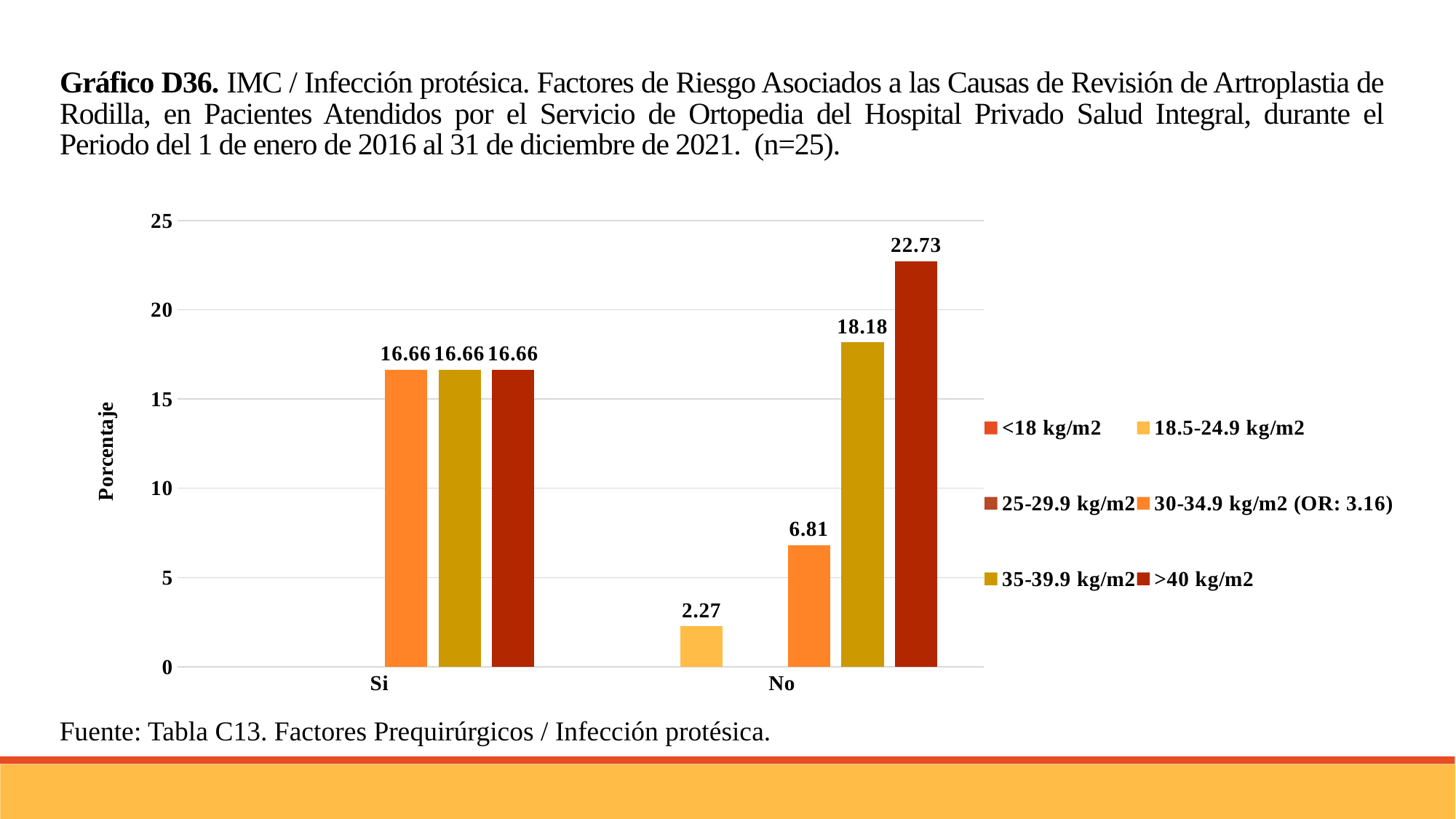
What is the value for 35-39.9 kg/m2 in the No category? 18.18 How many series does the legend list? 6 What is the value for 18.5-24.9 kg/m2 in the No category? 2.27 What is the value for 30-34.9 kg/m2 (OR: 3.16) in the No category? 6.81 Which series has the lowest value in the No category? 18.5-24.9 kg/m2 What is the difference between the >40 kg/m2 value and the 35-39.9 kg/m2 value in the No category? 4.55 Which series has the highest value in the No category? >40 kg/m2 What is the label of the y axis? Porcentaje What is the value for >40 kg/m2 in the No category? 22.73 What is the value for >40 kg/m2 in the Si category? 16.66 How many categories are shown on the x axis? 2 What type of chart is shown on the slide? bar chart